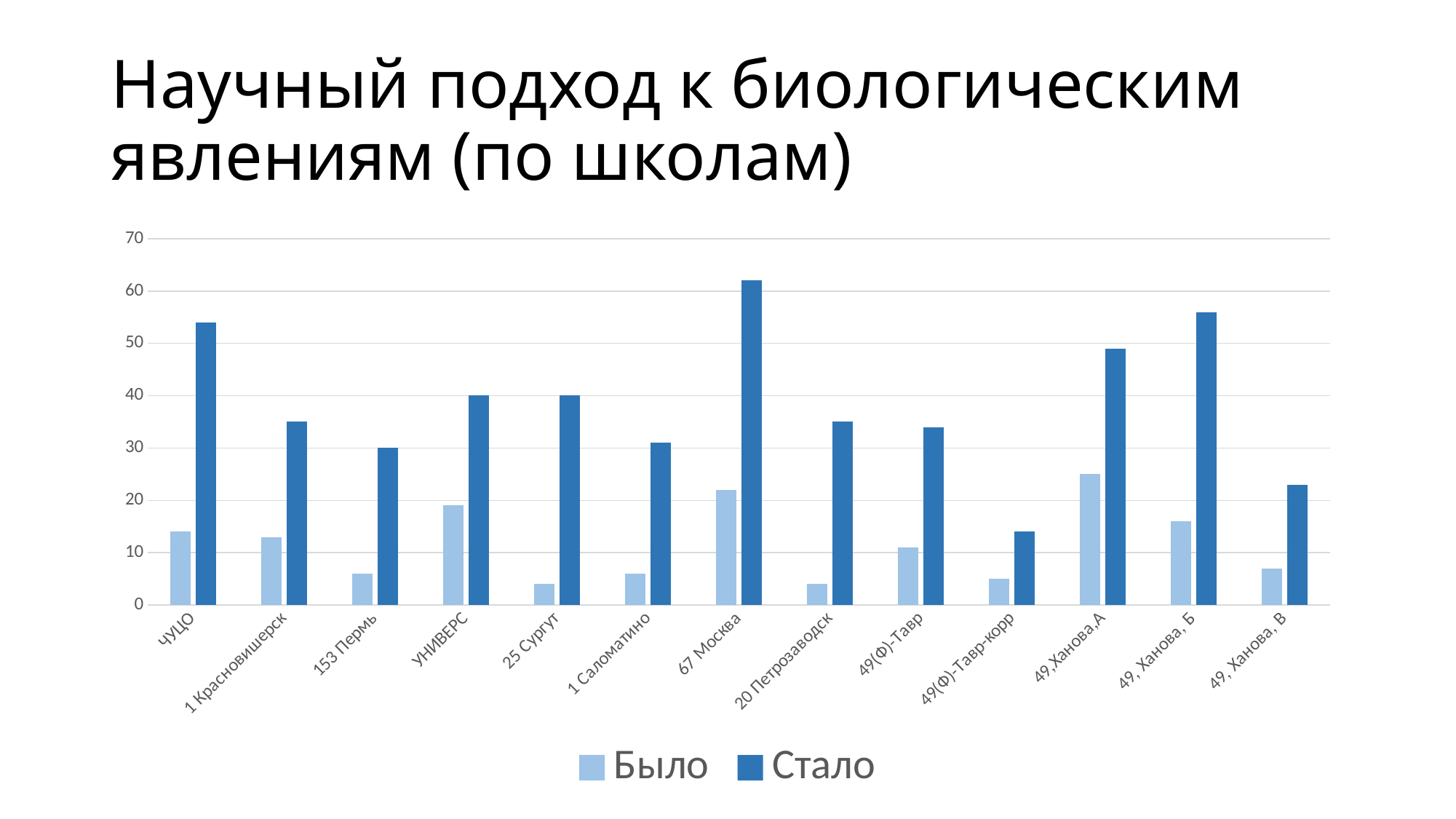
Which school has the lowest Стало value? 49(Ф)-Тавр-корр Which is larger: the Стало value for 49,Ханова,А or for 49, Ханова, Б? 49, Ханова, Б Is the Стало value for ЧУЦО greater or less than 50? greater How many schools (categories) are shown on the x axis? 13 What is the Стало value for 153 Пермь? 30 What are the two series named in the legend? Было and Стало What kind of chart is shown on the slide? bar chart How many series does the legend list? 2 Is the Стало value for 49, Ханова, В greater or less than 30? less Which school has the highest Стало value? 67 Москва What is the Стало value for УНИВЕРС? 40 Which is larger: the Было value for УНИВЕРС or for 153 Пермь? УНИВЕРС